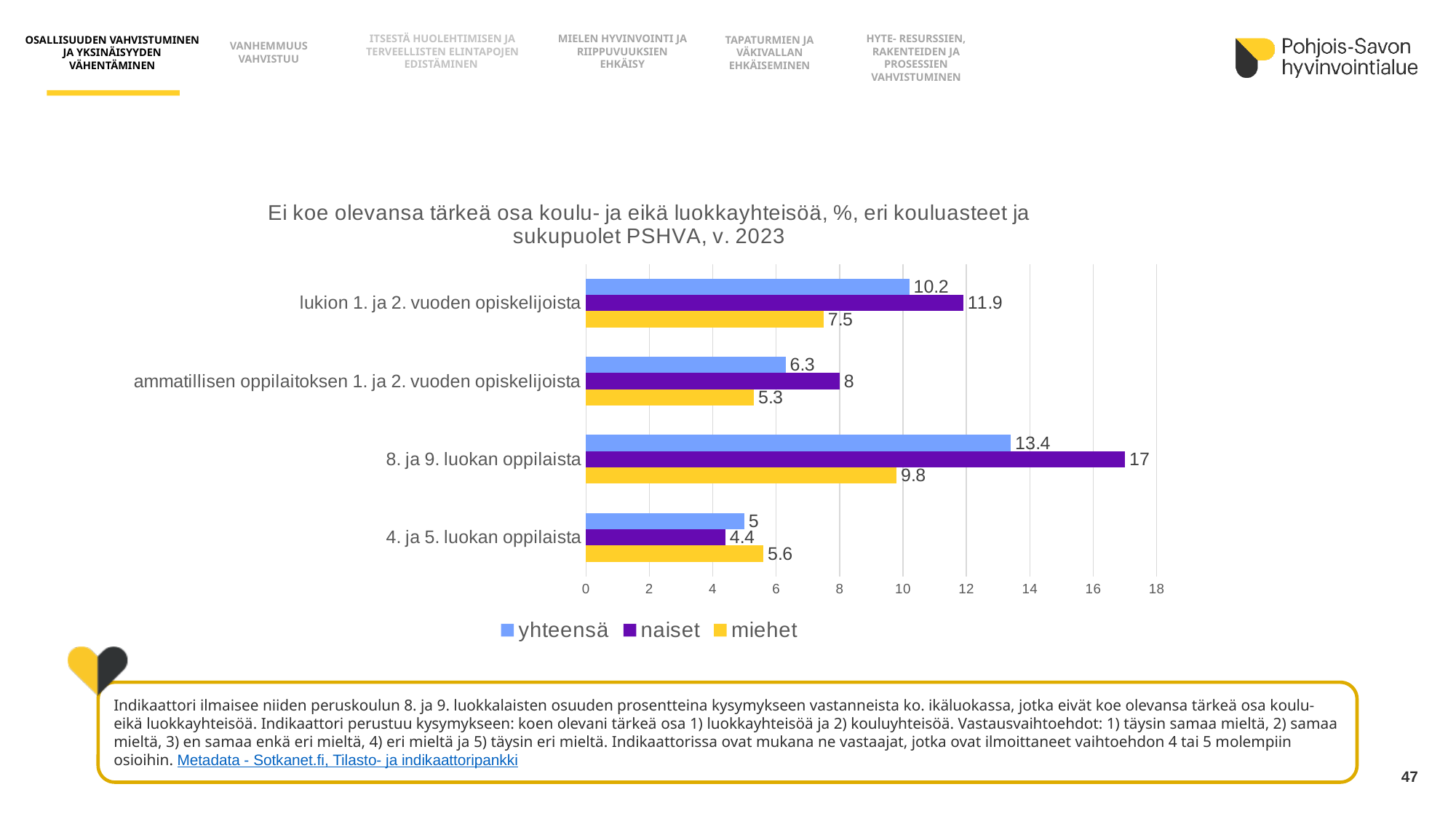
What kind of chart is shown on the slide? bar chart For 4. ja 5. luokan oppilaista, which is larger: the naiset value or the miehet value? miehet Which colour represents the miehet series? yellow Which category has the lowest yhteensä value? 4. ja 5. luokan oppilaista Which category has the highest naiset value? 8. ja 9. luokan oppilaista What is the yhteensä value for ammatillisen oppilaitoksen 1. ja 2. vuoden opiskelijoista? 6.3 What is the value for miehet among lukion 1. ja 2. vuoden opiskelijoista? 7.5 How many categories are shown on the y axis? 4 Is the yhteensä value for 8. ja 9. luokan oppilaista greater or less than 12? greater What is the difference between the naiset and miehet values for 8. ja 9. luokan oppilaista? 7.2 What is the value for naiset among 8. ja 9. luokan oppilaista? 17 How many series does the legend list? 3